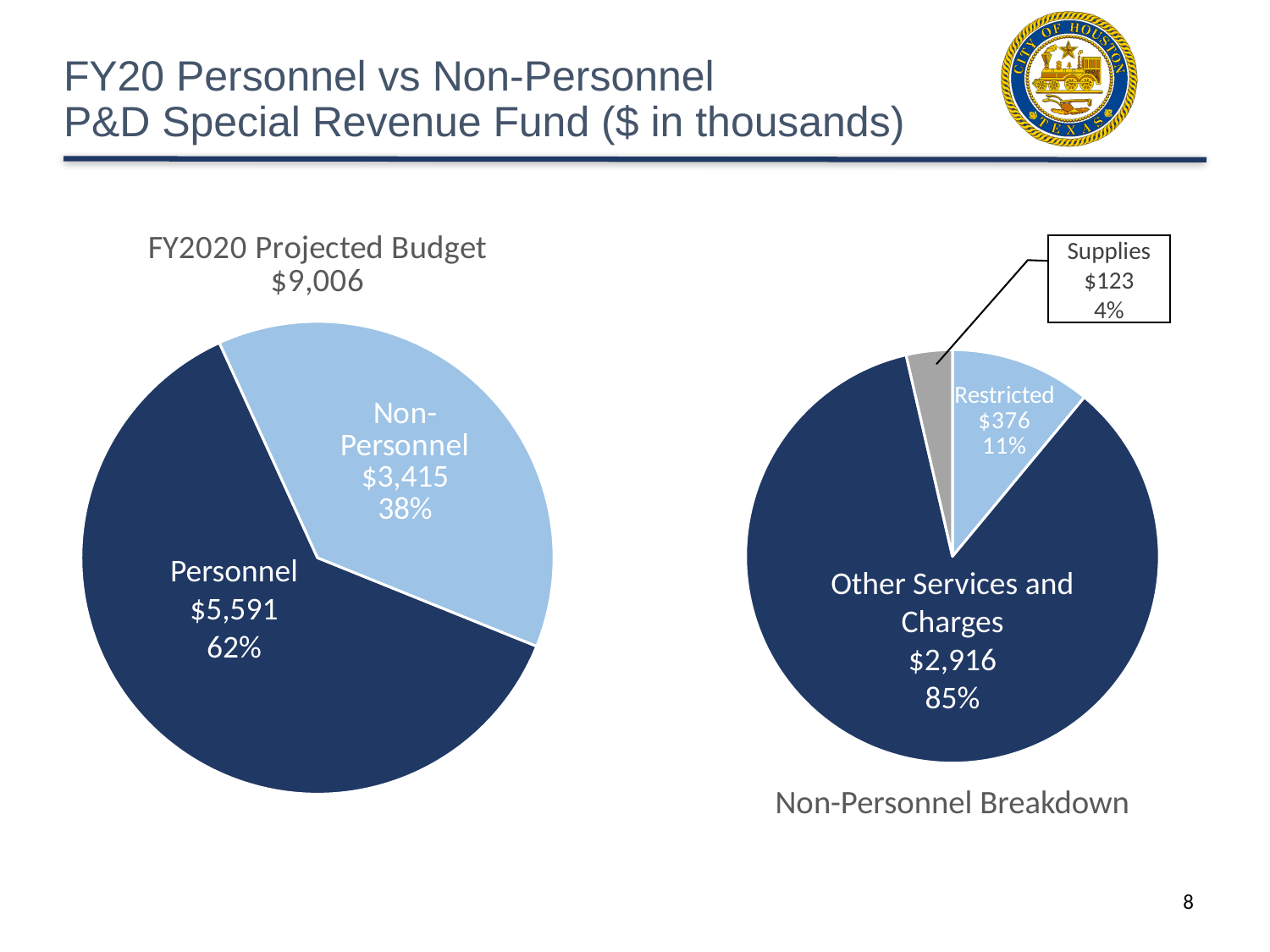
What kind of chart is the Non-Personnel Breakdown chart? Pie chart In the FY2020 Projected Budget pie chart, what is the value for Personnel? $5,591 In the Non-Personnel Breakdown pie chart, what share of the pie is Supplies? 4% What total is shown under the title of the FY2020 Projected Budget chart? $9,006 In the FY2020 Projected Budget pie chart, what is the difference between Personnel and Non-Personnel? $2,176 In the FY2020 Projected Budget pie chart, how many slices are there? 2 In the Non-Personnel Breakdown pie chart, what is the value for Restricted? $376 In the Non-Personnel Breakdown pie chart, what is the difference between Other Services and Charges and Restricted? $2,540 In the FY2020 Projected Budget pie chart, what share of the pie is Non-Personnel? 38% In the FY2020 Projected Budget pie chart, which category is the largest? Personnel In the Non-Personnel Breakdown pie chart, which is larger, Restricted or Supplies? Restricted In the Non-Personnel Breakdown pie chart, which category is the smallest? Supplies